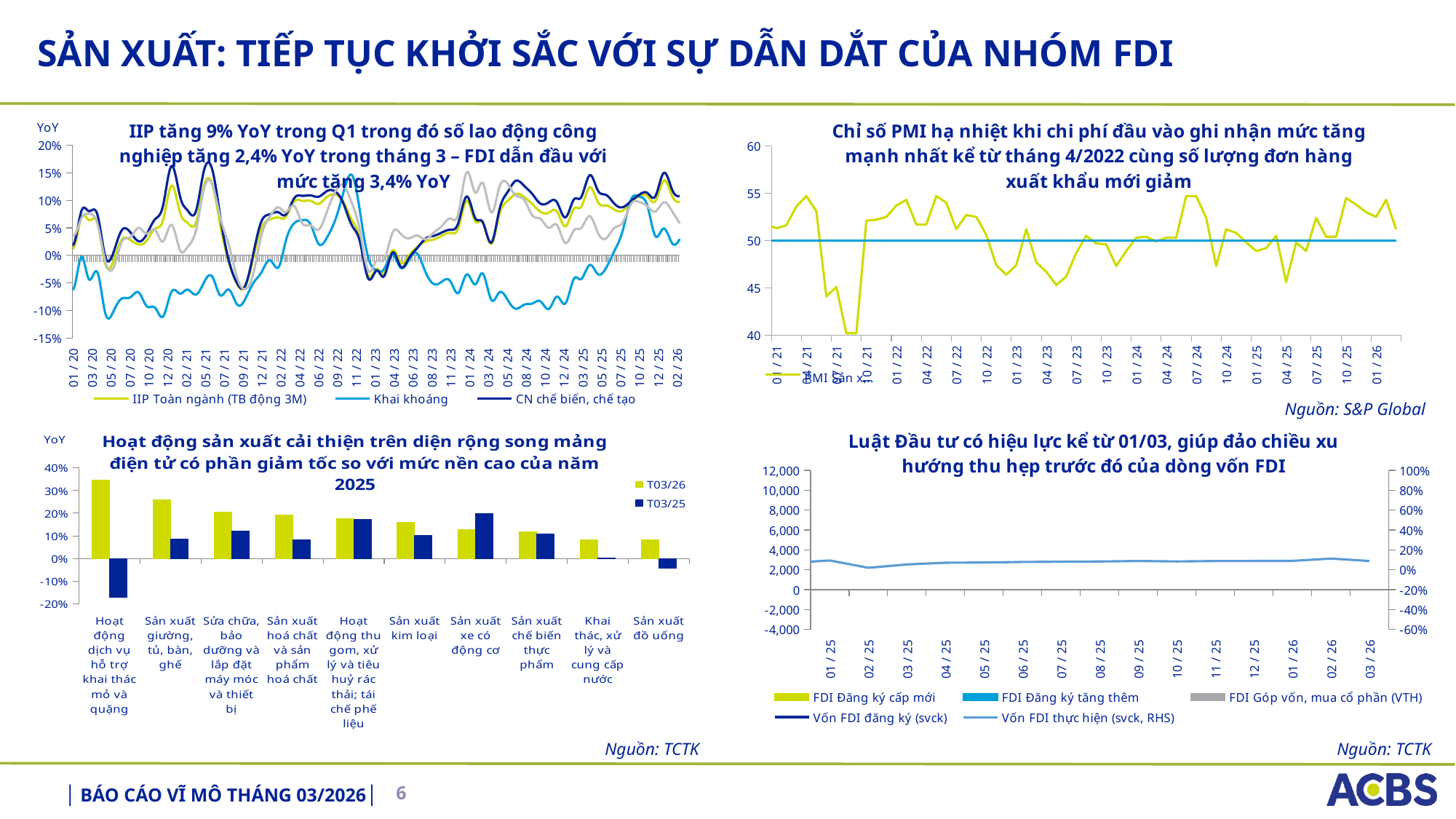
In the bottom-left bar chart, which category has the highest T03/26 value? Hoạt động dịch vụ hỗ trợ khai thác mỏ và quặng In the bottom-left bar chart, how many series does the legend list? 2 In the bottom-left bar chart, which is larger for Sản xuất giường, tủ, bàn, ghế: the T03/26 value or the T03/25 value? T03/26 In the bottom-left bar chart, which category has the lowest T03/25 value? Hoạt động dịch vụ hỗ trợ khai thác mỏ và quặng What kind of chart is the bottom-left chart titled 'Hoạt động sản xuất cải thiện trên diện rộng...'? Bar chart In the bottom-left bar chart, is the T03/26 value for Hoạt động dịch vụ hỗ trợ khai thác mỏ và quặng greater or less than 30%? greater In the top-right PMI chart, is the PMI sản xuất value at 01/26 greater or less than 50? greater In the top-left IIP chart, is the Khai khoáng value at 11/22 greater or less than 10%? greater In the top-left chart titled 'IIP tăng 9% YoY trong Q1...', how many series does the legend list? 3 In the bottom-right chart titled 'Luật Đầu tư có hiệu lực kể từ 01/03...', how many series does the legend list? 5 In the bottom-left bar chart, which category has the highest T03/25 value? Sản xuất xe có động cơ In the bottom-left bar chart, how many categories are shown on the x axis? 10